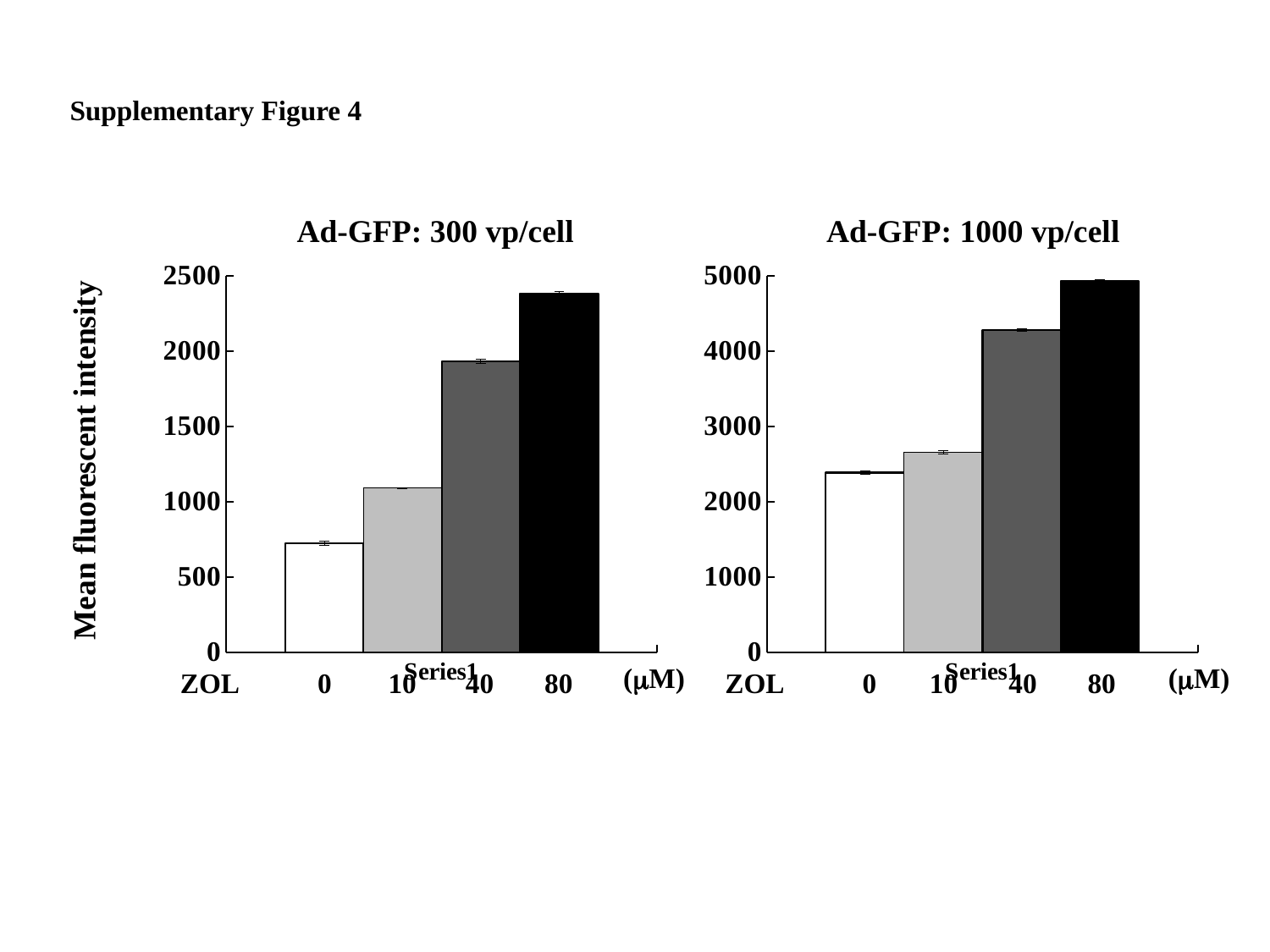
In the 'Ad-GFP: 1000 vp/cell' chart, which is larger: the value for ZOL 40 µM or ZOL 10 µM? ZOL 40 µM In the 'Ad-GFP: 1000 vp/cell' chart, which ZOL concentration has the lowest mean fluorescent intensity? 0 What is the y-axis label shared by the two charts? Mean fluorescent intensity In the 'Ad-GFP: 300 vp/cell' chart, which ZOL concentration has the highest mean fluorescent intensity? 80 How many ZOL concentrations are plotted in the 'Ad-GFP: 300 vp/cell' chart? 4 What kind of chart is the 'Ad-GFP: 300 vp/cell' chart? bar chart In the 'Ad-GFP: 1000 vp/cell' chart, is the value for ZOL 10 µM greater or less than 3000? less In the 'Ad-GFP: 300 vp/cell' chart, do the values rise or fall as the ZOL concentration increases along the x axis? rise In the 'Ad-GFP: 1000 vp/cell' chart, is the value for ZOL 80 µM greater or less than 4000? greater In the 'Ad-GFP: 300 vp/cell' chart, is the value for ZOL 0 µM greater or less than 1000? less